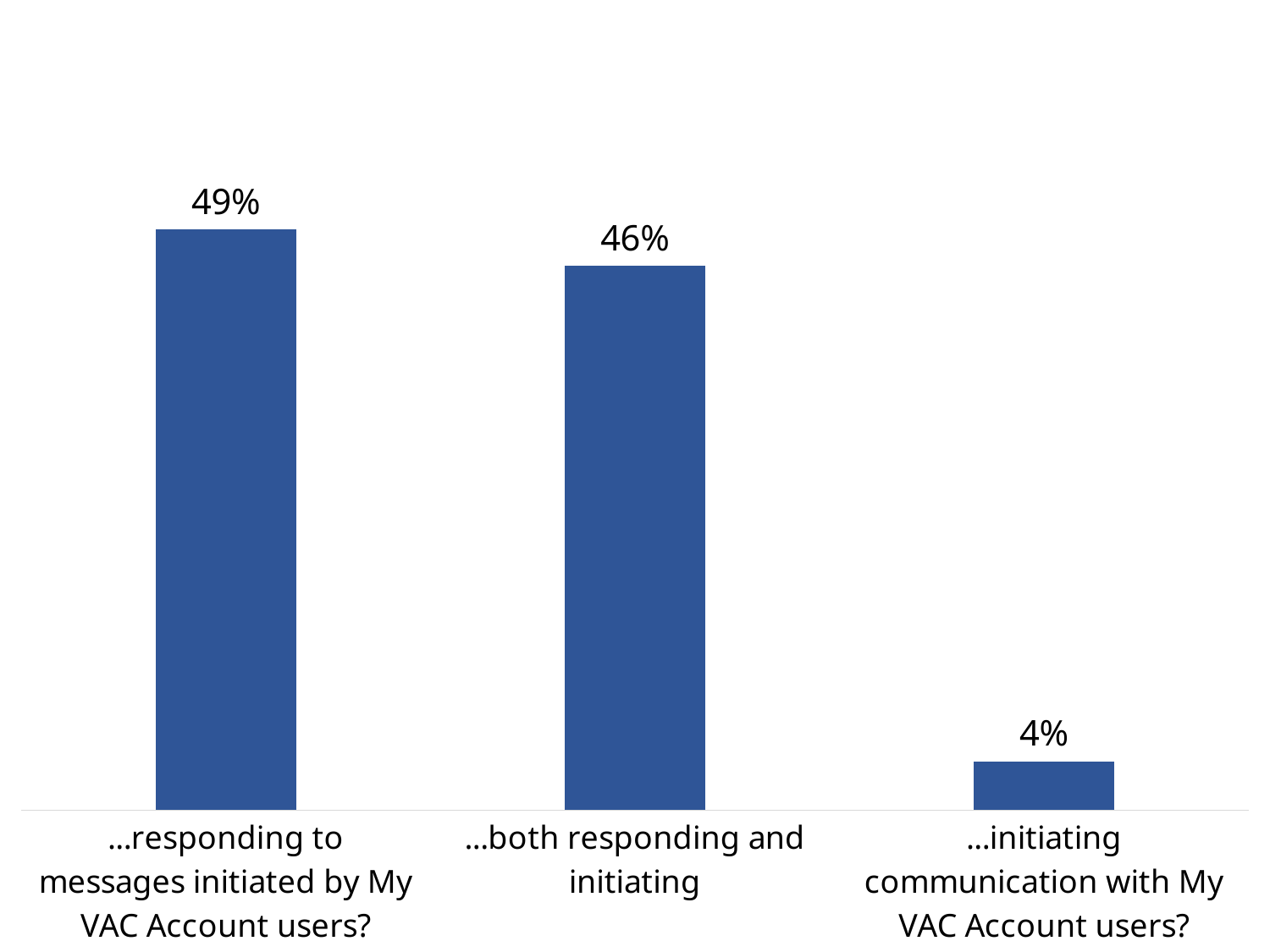
What kind of chart is shown on the slide? Bar chart What colour are the bars in the chart? Blue Which is larger: the value for "...both responding and initiating" or the value for "...initiating communication with My VAC Account users?"? ...both responding and initiating Do the values rise or fall from left to right across the categories? Fall Which category has the highest value? ...responding to messages initiated by My VAC Account users? What is the difference between the values for "...both responding and initiating" and "...initiating communication with My VAC Account users?"? 42% Which category has the lowest value? ...initiating communication with My VAC Account users? What is the difference between the values for "...responding to messages initiated by My VAC Account users?" and "...both responding and initiating"? 3% What is the value for "...responding to messages initiated by My VAC Account users?"? 49% What is the value for "...initiating communication with My VAC Account users?"? 4% How many categories are shown in the chart? 3 What is the value for "...both responding and initiating"? 46%